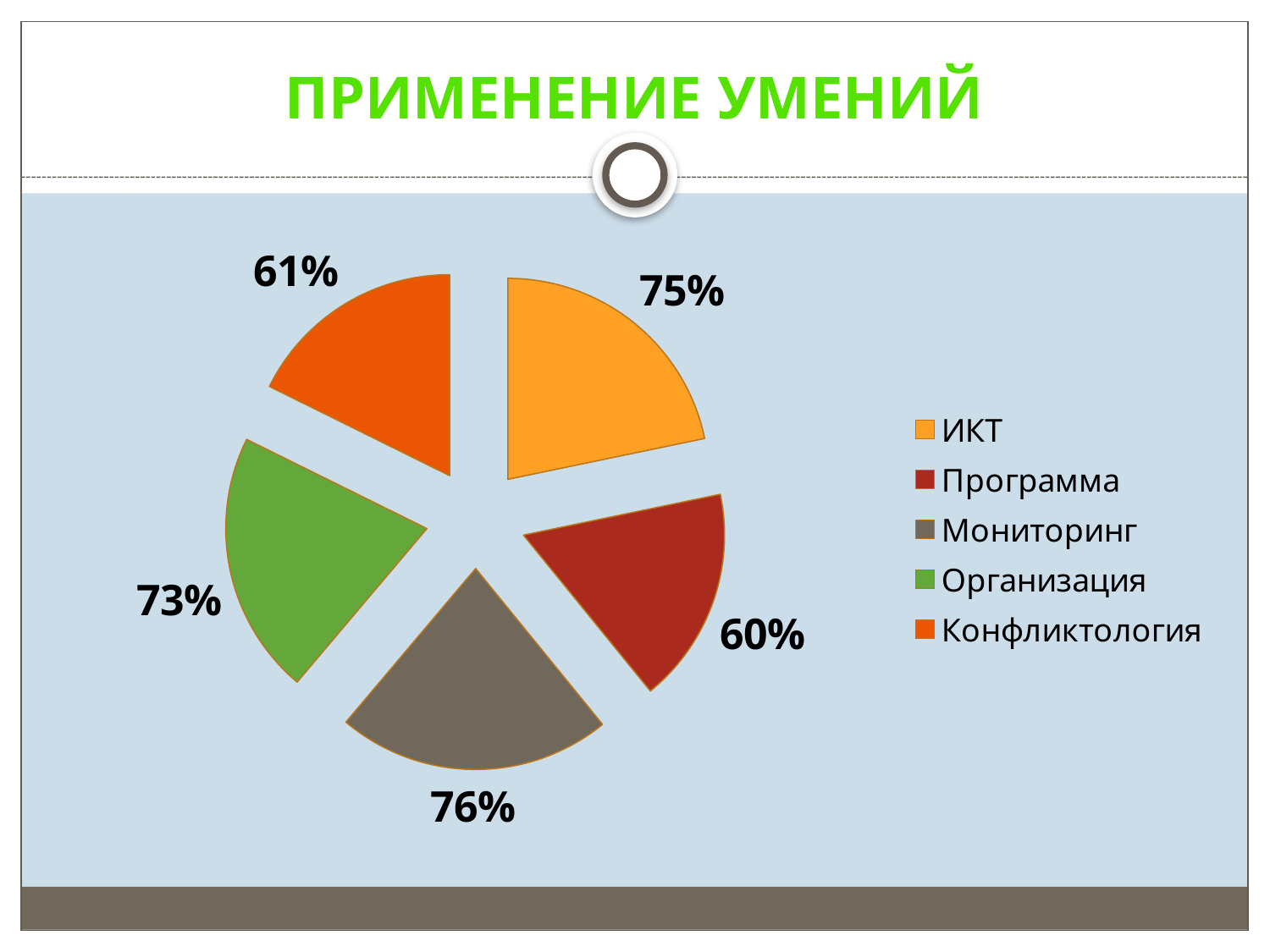
How many categories does the legend list? 5 What is the title of the slide's chart? ПРИМЕНЕНИЕ УМЕНИЙ What value is shown for Мониторинг? 76% Which is larger, the value for Организация or the value for Конфликтология? Организация What value is shown for Конфликтология? 61% What type of chart is shown on the slide? pie chart Which category has the highest value? Мониторинг What value is shown for Организация? 73% What value is shown for ИКТ? 75% What value is shown for Программа? 60% What is the difference between the values for ИКТ and Программа? 15% Which category has the lowest value? Программа